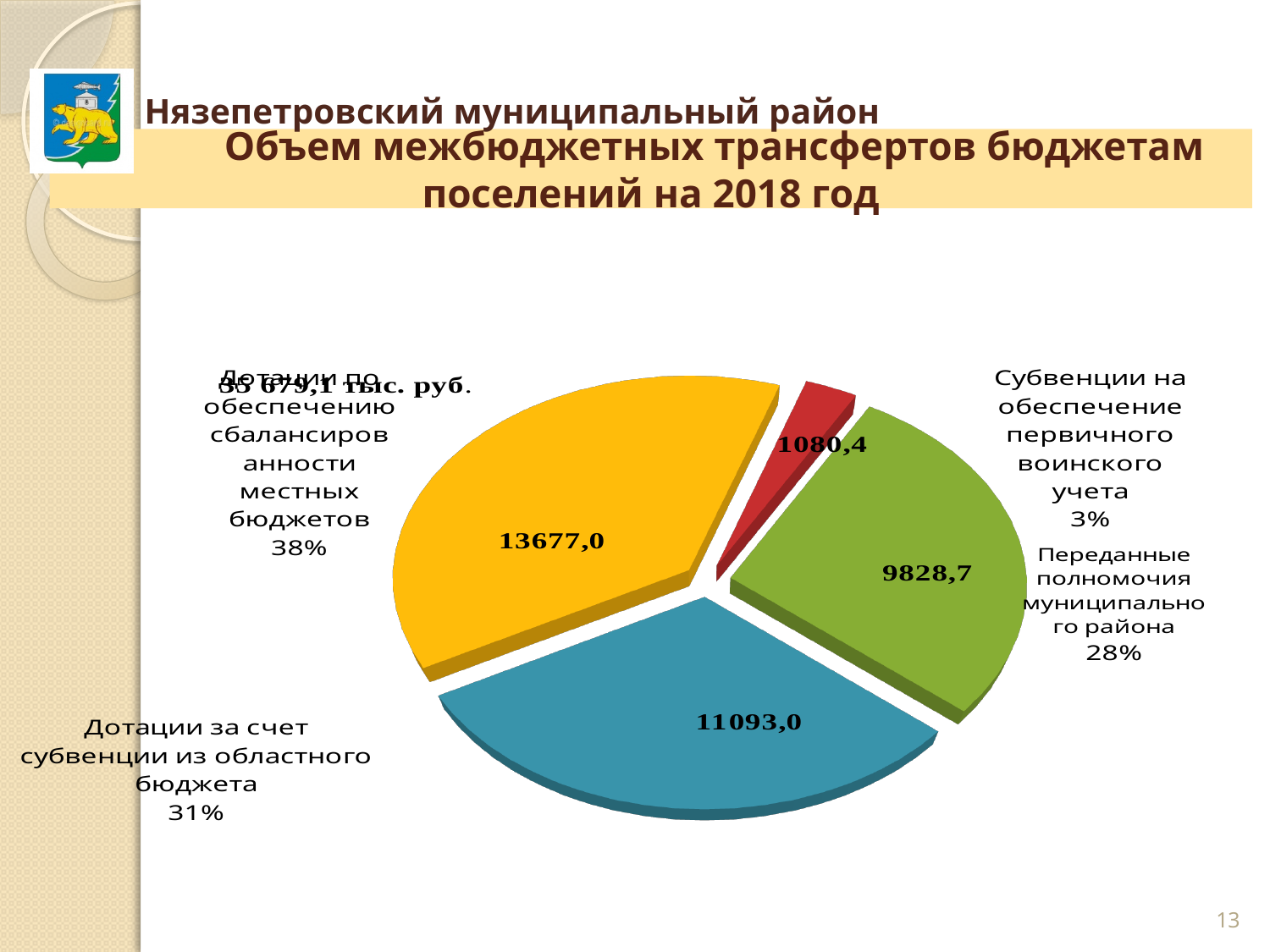
What is the value of the slice for Переданные полномочия муниципального района? 9828,7 Which category has the largest slice of the pie? Дотации по обеспечению сбалансированности местных бюджетов What is the value of the slice for Дотации за счет субвенции из областного бюджета? 11093,0 Which is larger: the slice for Дотации за счет субвенции из областного бюджета or the slice for Переданные полномочия муниципального района? Дотации за счет субвенции из областного бюджета What colour is the slice for Переданные полномочия муниципального района? green What kind of chart is shown on the slide? pie chart Which category has the smallest slice of the pie? Субвенции на обеспечение первичного воинского учета How many slices does the pie chart have? 4 What is the value of the slice for Дотации по обеспечению сбалансированности местных бюджетов? 13677,0 What is the value of the slice for Субвенции на обеспечение первичного воинского учета? 1080,4 What share of the pie does Переданные полномочия муниципального района represent? 28% What share of the pie does Дотации за счет субвенции из областного бюджета represent? 31%